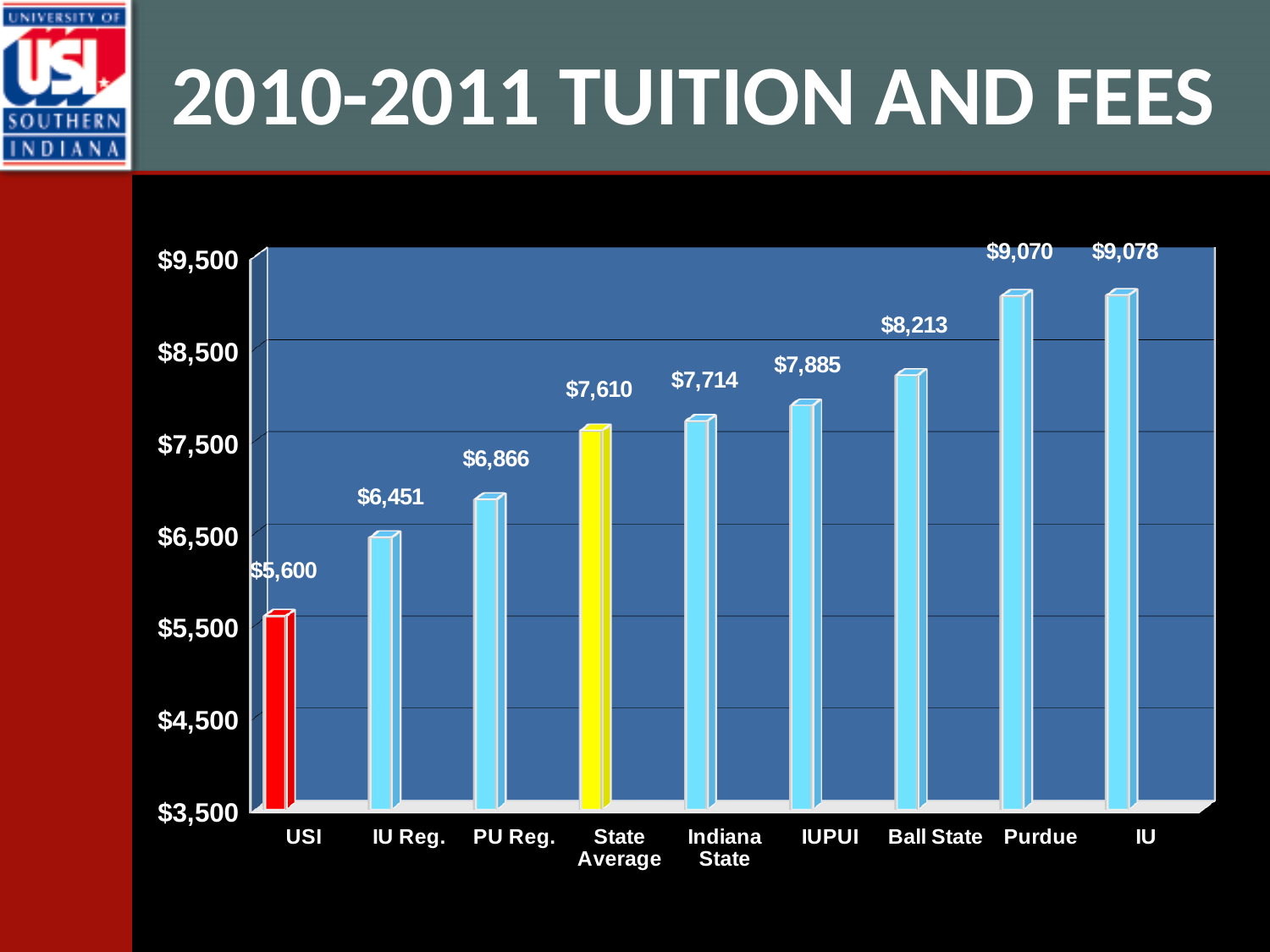
What colour is the bar for USI? red What is the value for USI? $5,600 What is the difference between the State Average and the value for USI? $2,010 How many categories are shown on the x axis? 9 What is the difference between the values for IU and USI? $3,478 Is the value for Ball State greater or less than $8,500? less Which is larger, the value for IUPUI or the value for PU Reg.? IUPUI What is the value for Ball State? $8,213 What is the value for the State Average? $7,610 What kind of chart is shown on the slide? bar chart Which category has the highest value? IU Which category has the lowest value? USI